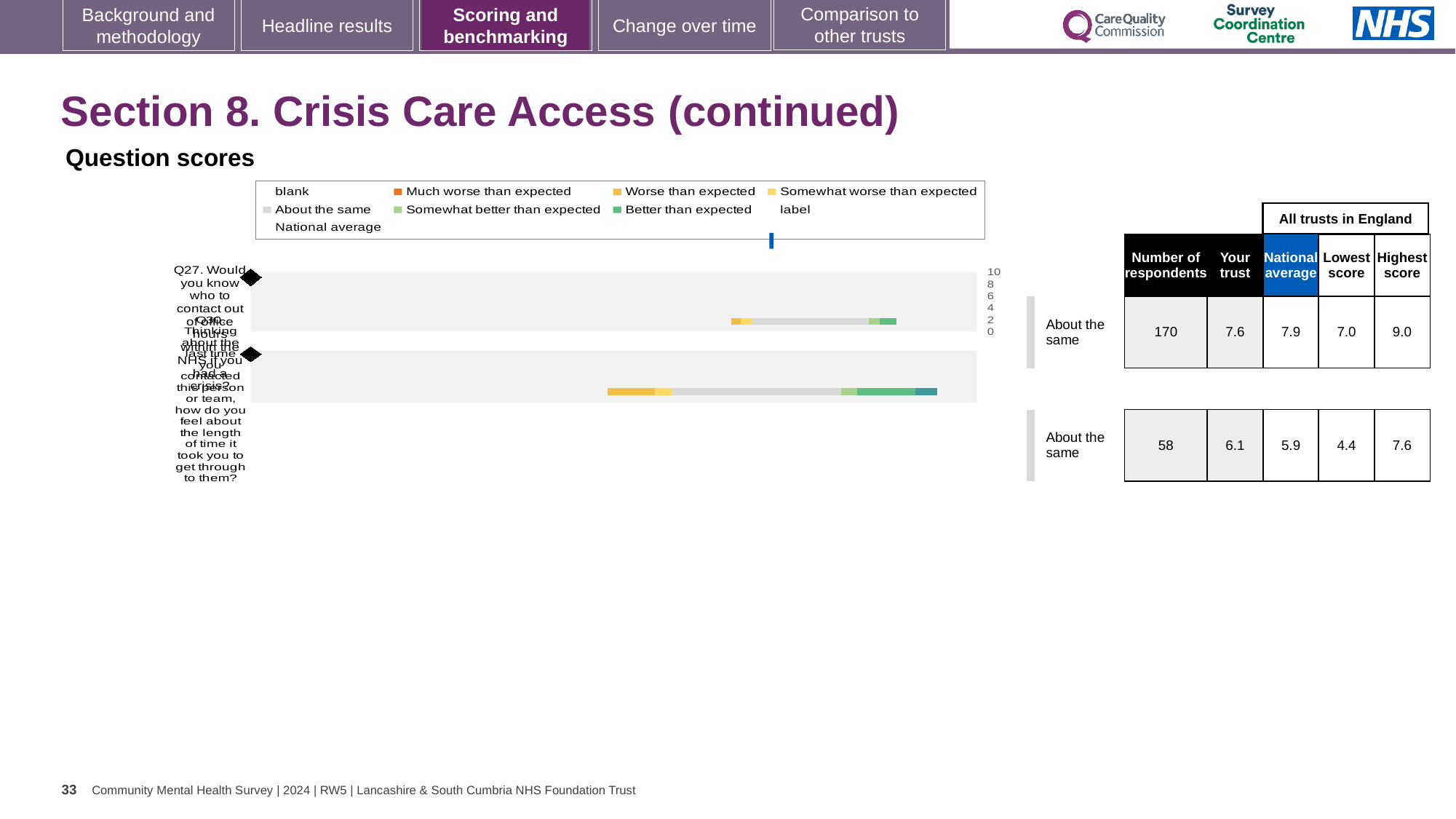
In the table beside the chart, what is the 'Your trust' score for Q27? 7.6 In the table beside the chart, how many respondents answered Q27? 170 What is the highest value shown on the chart's score axis? 10 In the table beside the chart, what is the national average for Q30? 5.9 How many survey questions are plotted as bars in the chart? 2 What benchmark category is shown next to both Q27 and Q30 in the chart? About the same In the table beside the chart, which is larger for Q30: the 'Your trust' score or the national average? Your trust In the table beside the chart, what is the highest score among all trusts in England for Q27? 9.0 What kind of chart is shown under 'Question scores'? Stacked bar chart In the table beside the chart, what is the lowest score among all trusts in England for Q30? 4.4 Which legend entry is shown in orange? Much worse than expected In the table beside the chart, what is the difference between the national average and the 'Your trust' score for Q27? 0.3